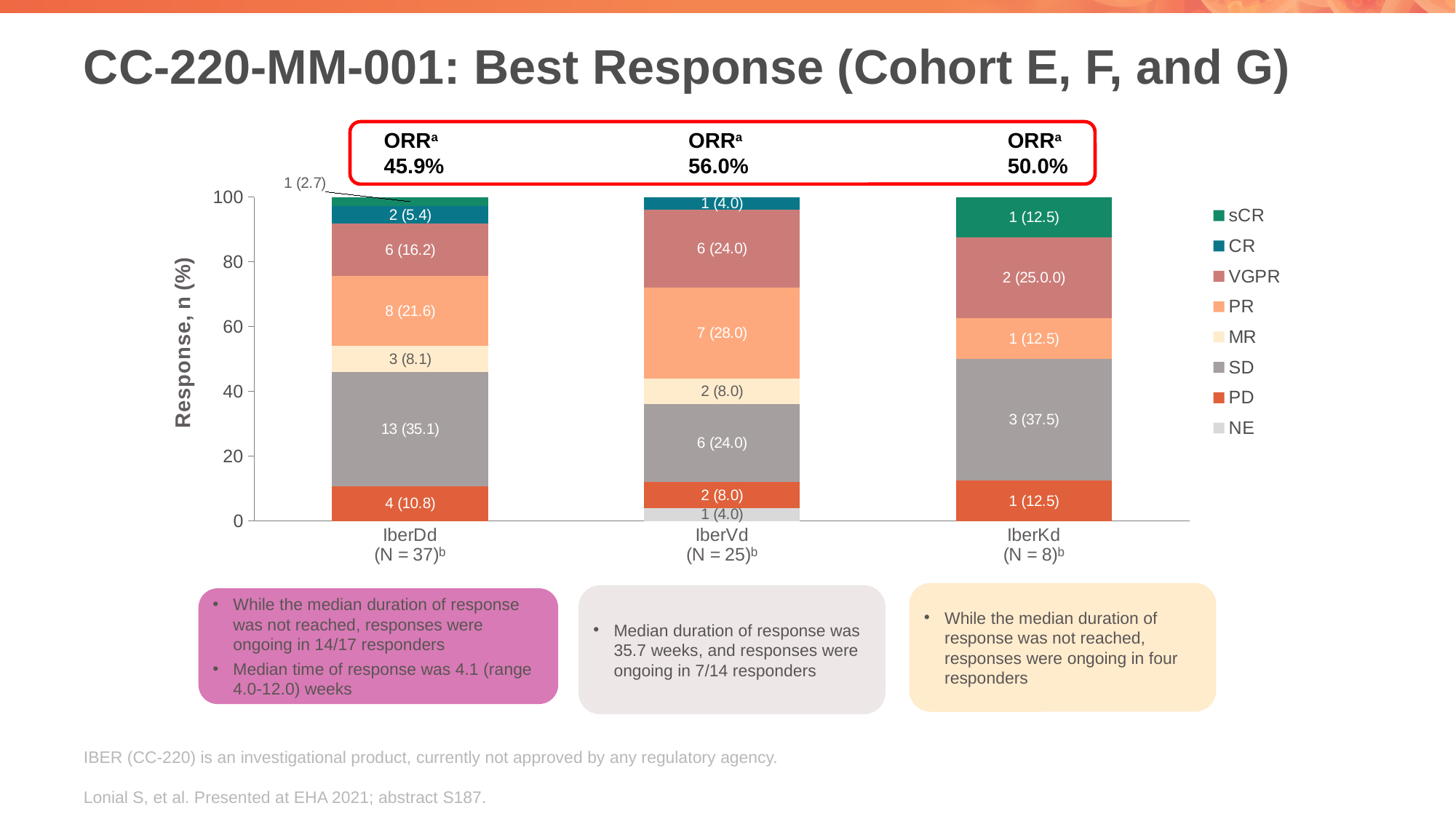
What kind of chart is shown on the slide? Stacked bar chart What is the label on the y axis of the chart? Response, n (%) Which is larger: the number of PR patients in the IberDd bar or in the IberVd bar? IberDd What is the data label for the SD segment of the IberKd bar? 3 (37.5) What is the data label for the PD segment of the IberDd bar? 4 (10.8) What is the data label for the SD segment of the IberDd bar? 13 (35.1) How many response categories does the chart legend list? 8 Which treatment group has the highest ORR shown above the bars? IberVd What ORR is shown above the IberVd bar? 56.0% Which treatment group has the lowest ORR shown above the bars? IberDd What is the data label for the PR segment of the IberVd bar? 7 (28.0) How many treatment groups (bars) are shown on the x axis of the chart? 3